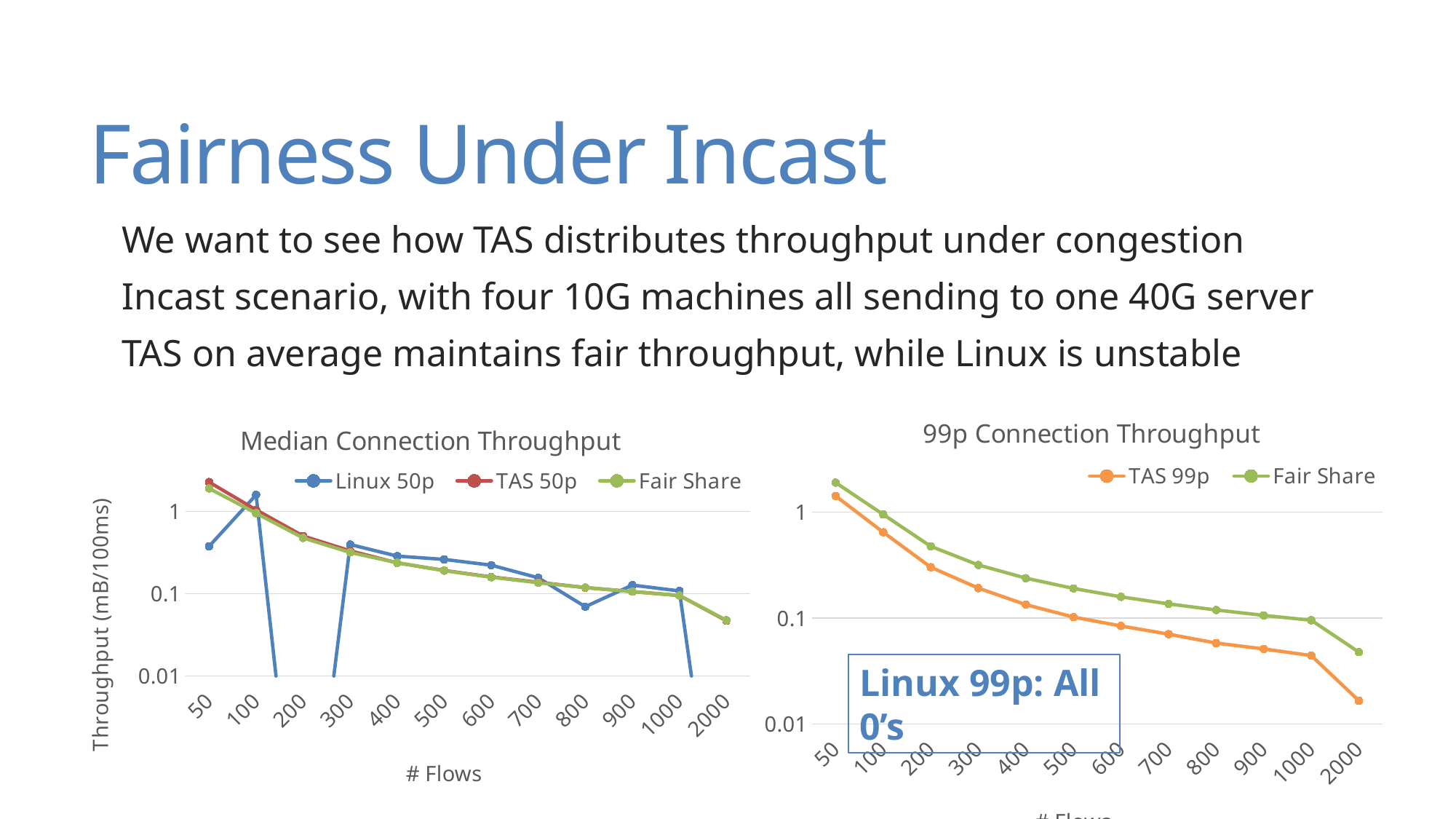
How many series does the legend of the Median Connection Throughput chart list? 3 In the 99p Connection Throughput chart, is the value for Fair Share at 50 flows greater or less than 1? greater In the Median Connection Throughput chart, is the value for Linux 50p at 50 flows greater or less than 1? less In the 99p Connection Throughput chart, does the Fair Share series rise or fall as the number of flows increases? fall In the Median Connection Throughput chart, is the value for Fair Share at 2000 flows greater or less than 0.1? less What is the y-axis label of the Median Connection Throughput chart? Throughput (mB/100ms) What kind of chart is the Median Connection Throughput chart? line chart How many series does the legend of the 99p Connection Throughput chart list? 2 How many # Flows categories are shown on the x axis of the 99p Connection Throughput chart? 12 In the 99p Connection Throughput chart, which series has the larger value at 2000 flows, TAS 99p or Fair Share? Fair Share